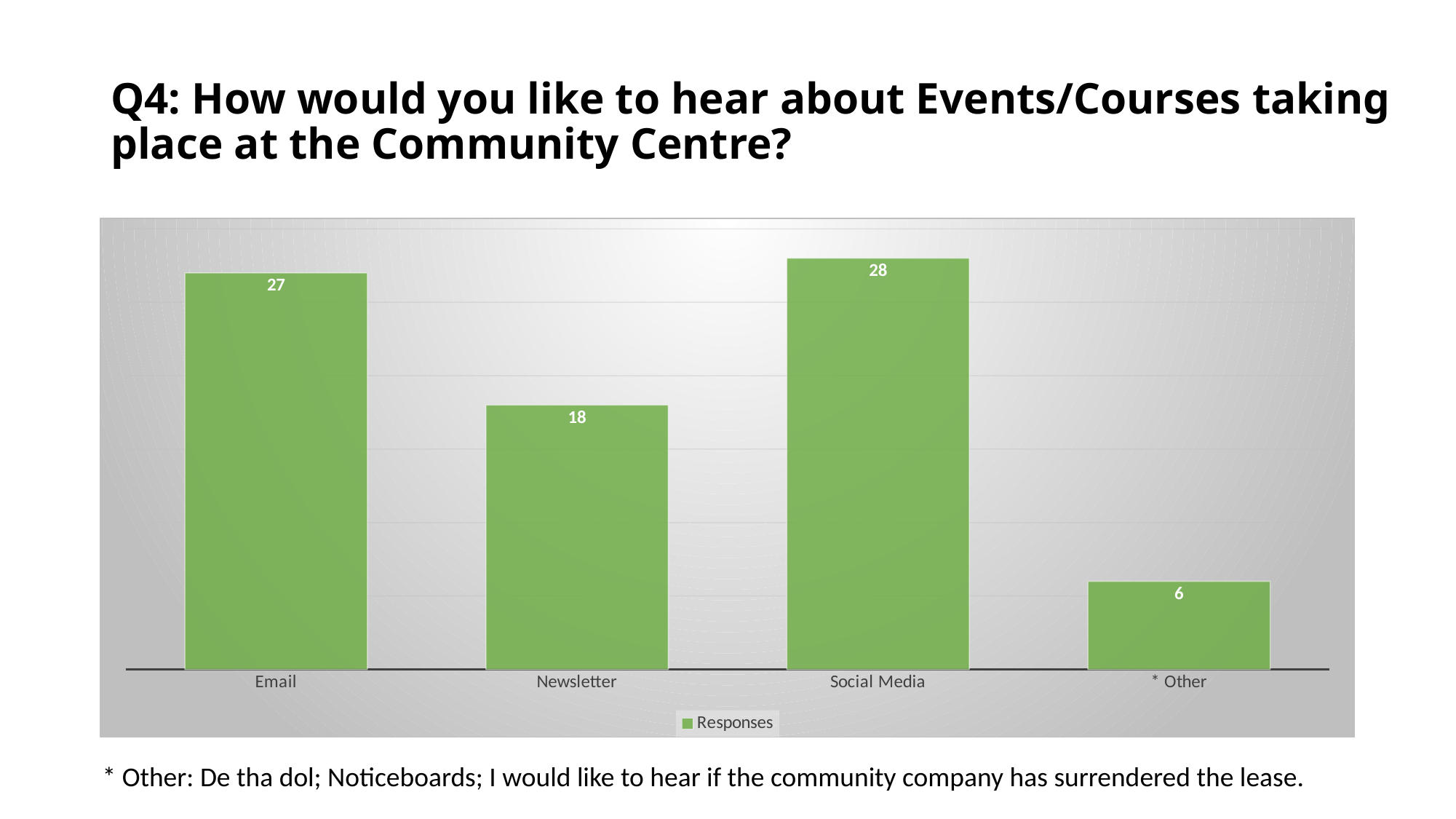
Which category has the lowest number of responses? * Other What is the difference in responses between Email and Newsletter? 9 Which has more responses, Newsletter or Email? Email What kind of chart is shown on the slide? Bar chart How many responses are shown for * Other? 6 How many responses are shown for Email? 27 How many responses are shown for Social Media? 28 Which category has the highest number of responses? Social Media How many responses are shown for Newsletter? 18 How many categories are shown on the x axis? 4 How many series does the legend list? 1 What is the difference in responses between Social Media and * Other? 22